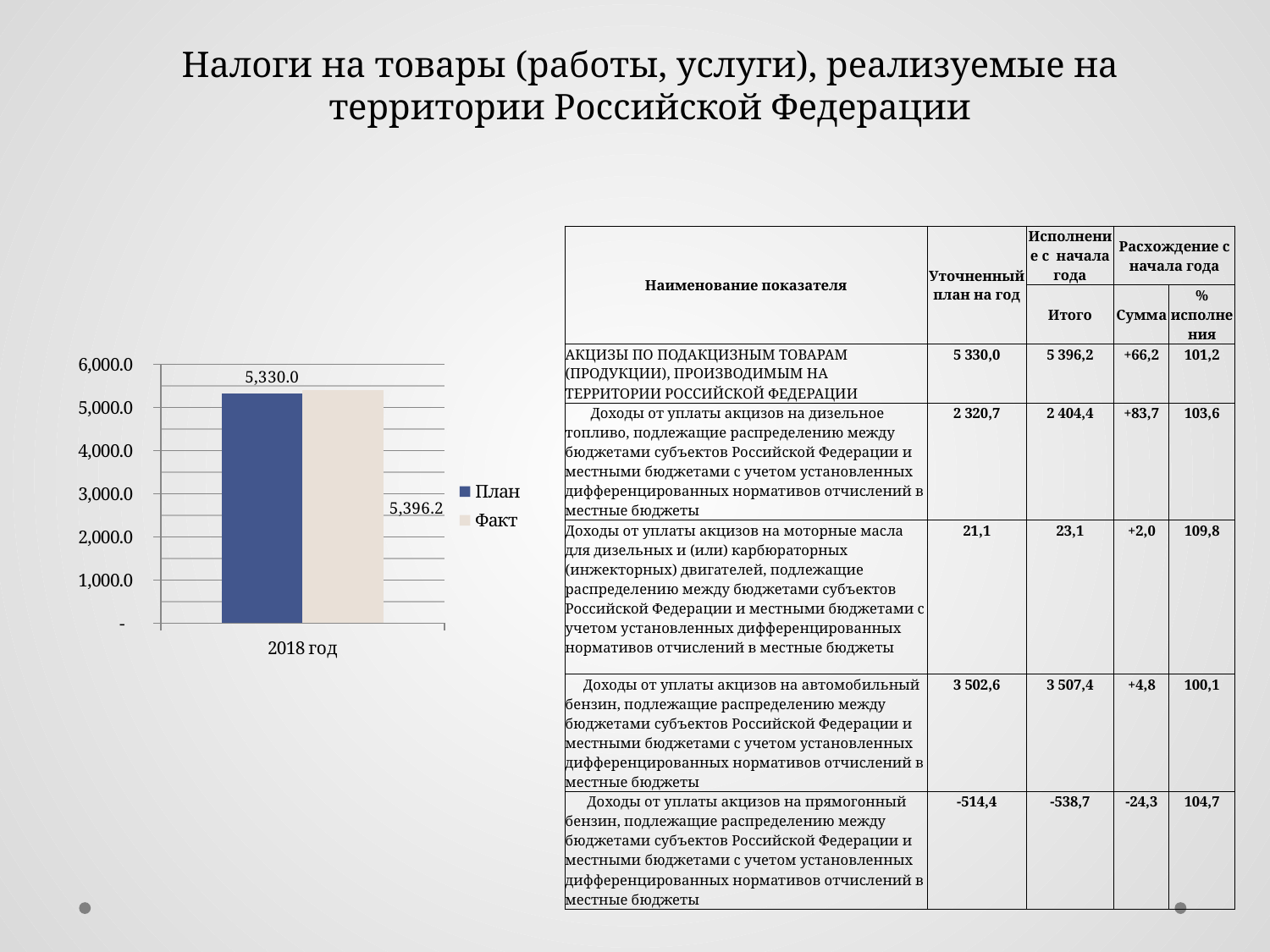
What is the difference between the Факт and План values for 2018 год? 66.2 Which series has the higher value for 2018 год, План or Факт? Факт Is the value for План greater or less than 5,000.0? greater How many categories are shown on the x axis of the chart? 1 What kind of chart is shown on the slide? bar chart Which series shows the lowest value on the chart? План What are the two entries in the chart legend? План and Факт What is the category label on the x axis of the chart? 2018 год What is the value of the Факт bar for 2018 год? 5,396.2 How many series does the chart legend list? 2 Is the value for Факт greater or less than 6,000.0? less What is the value of the План bar for 2018 год? 5,330.0